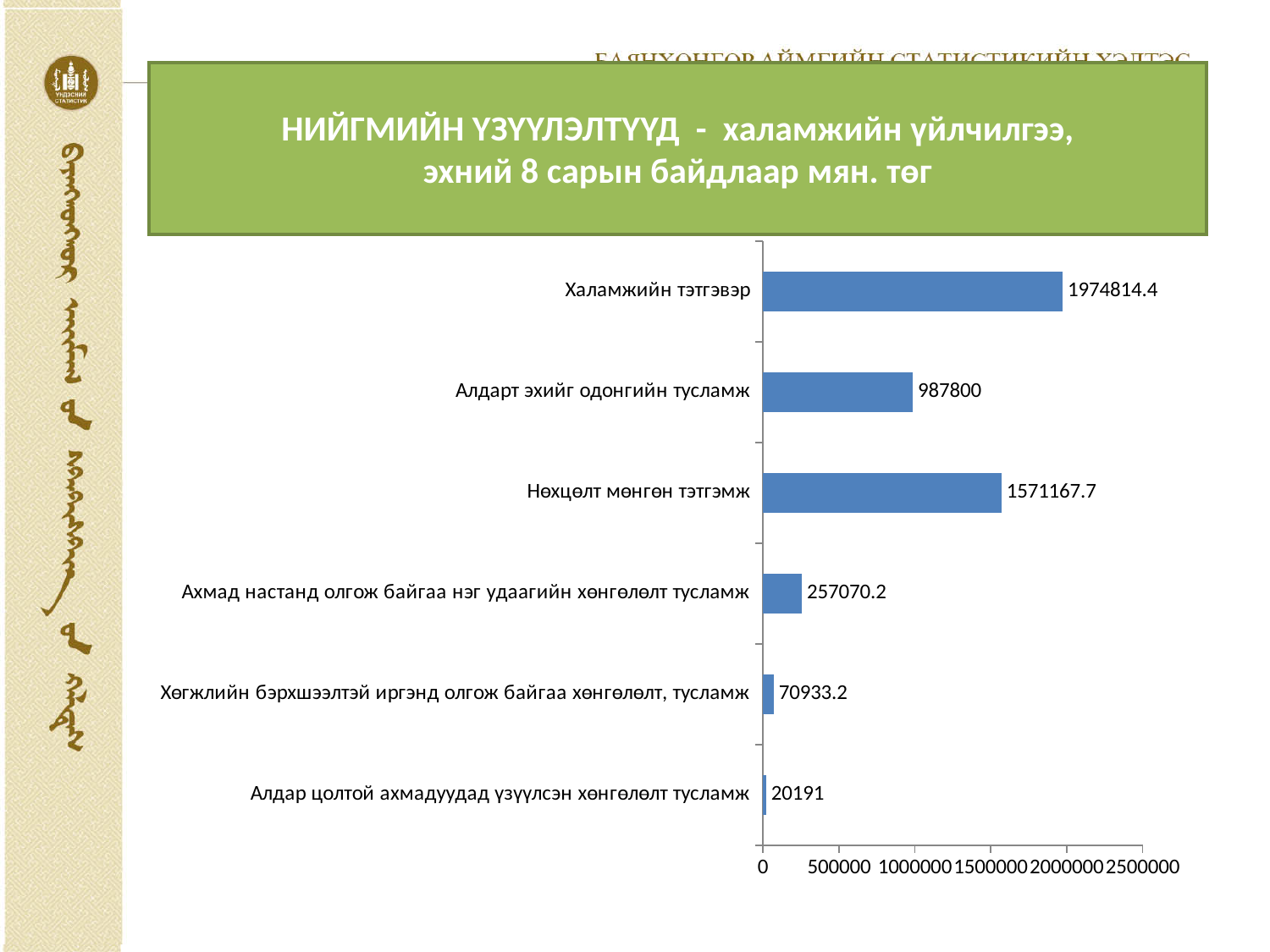
Which category has the highest value? Халамжийн тэтгэвэр Which category has the lowest value? Алдар цолтой ахмадуудад үзүүлсэн хөнгөлөлт тусламж Which is larger: Алдарт эхийг одонгийн тусламж or Ахмад настанд олгож байгаа нэг удаагийн хөнгөлөлт тусламж? Алдарт эхийг одонгийн тусламж How many categories are shown in the chart? 6 What is the value for Нөхцөлт мөнгөн тэтгэмж? 1571167.7 What is the value for Алдарт эхийг одонгийн тусламж? 987800 What is the value for Хөгжлийн бэрхшээлтэй иргэнд олгож байгаа хөнгөлөлт, тусламж? 70933.2 What kind of chart is shown on the slide? bar chart What is the value for Халамжийн тэтгэвэр? 1974814.4 Is the value for Нөхцөлт мөнгөн тэтгэмж greater or less than 1500000? greater What is the difference between Хөгжлийн бэрхшээлтэй иргэнд олгож байгаа хөнгөлөлт, тусламж and Алдар цолтой ахмадуудад үзүүлсэн хөнгөлөлт тусламж? 50742.2 What is the difference between Халамжийн тэтгэвэр and Нөхцөлт мөнгөн тэтгэмж? 403646.7